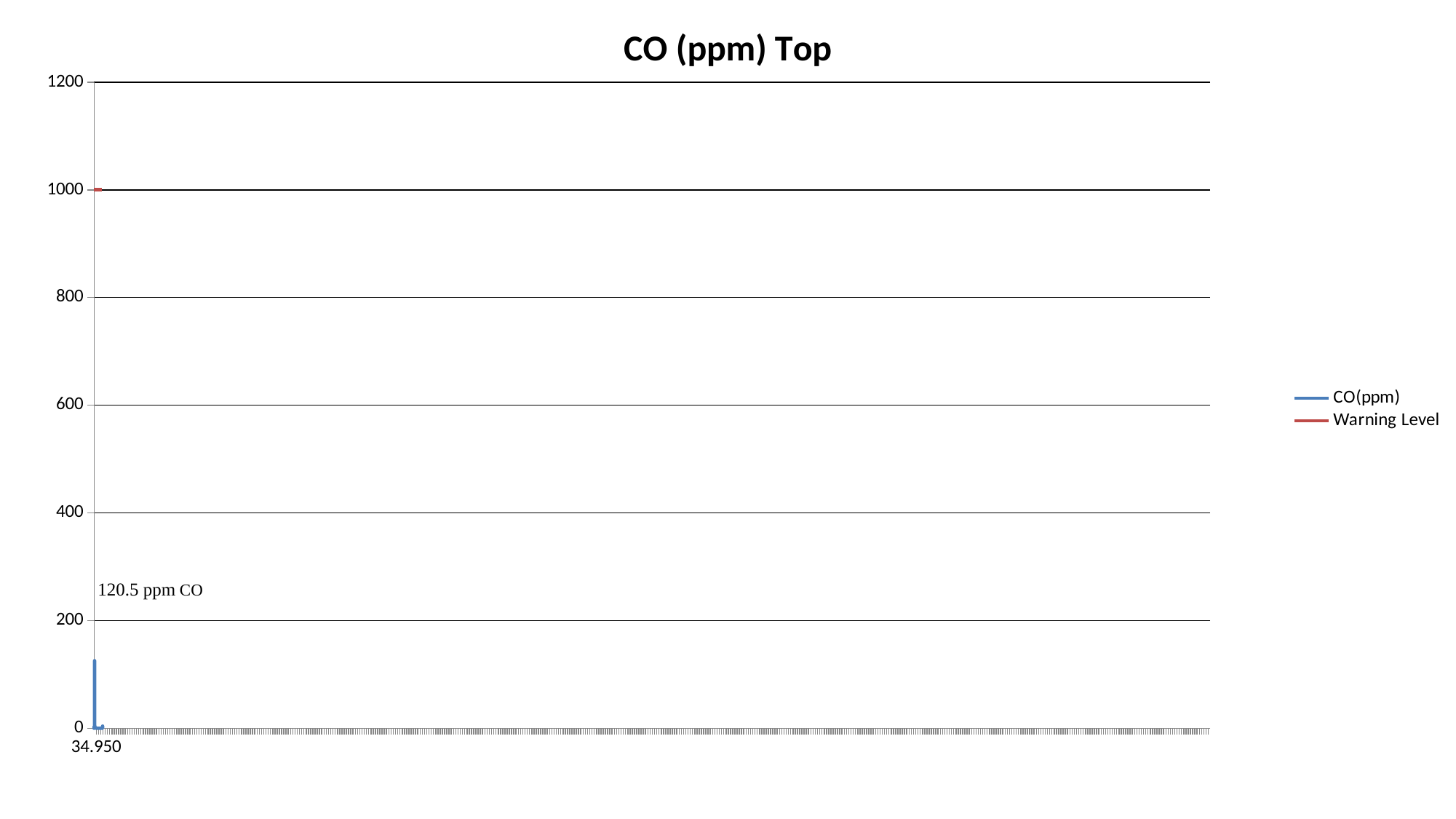
What is the title of the chart? CO (ppm) Top Is the Warning Level greater or less than 1200? less What kind of chart is shown on the slide? line chart Which is larger, the peak CO(ppm) value or the Warning Level? Warning Level Is the peak CO(ppm) value greater or less than 200? less How many series does the legend list? 2 What is the only x-axis label readable on the chart? 34.950 What is the peak CO value labelled on the chart? 120.5 ppm CO Is the Warning Level greater or less than 800? greater What colour is the CO(ppm) series in the legend? blue What is the highest value shown on the y axis? 1200